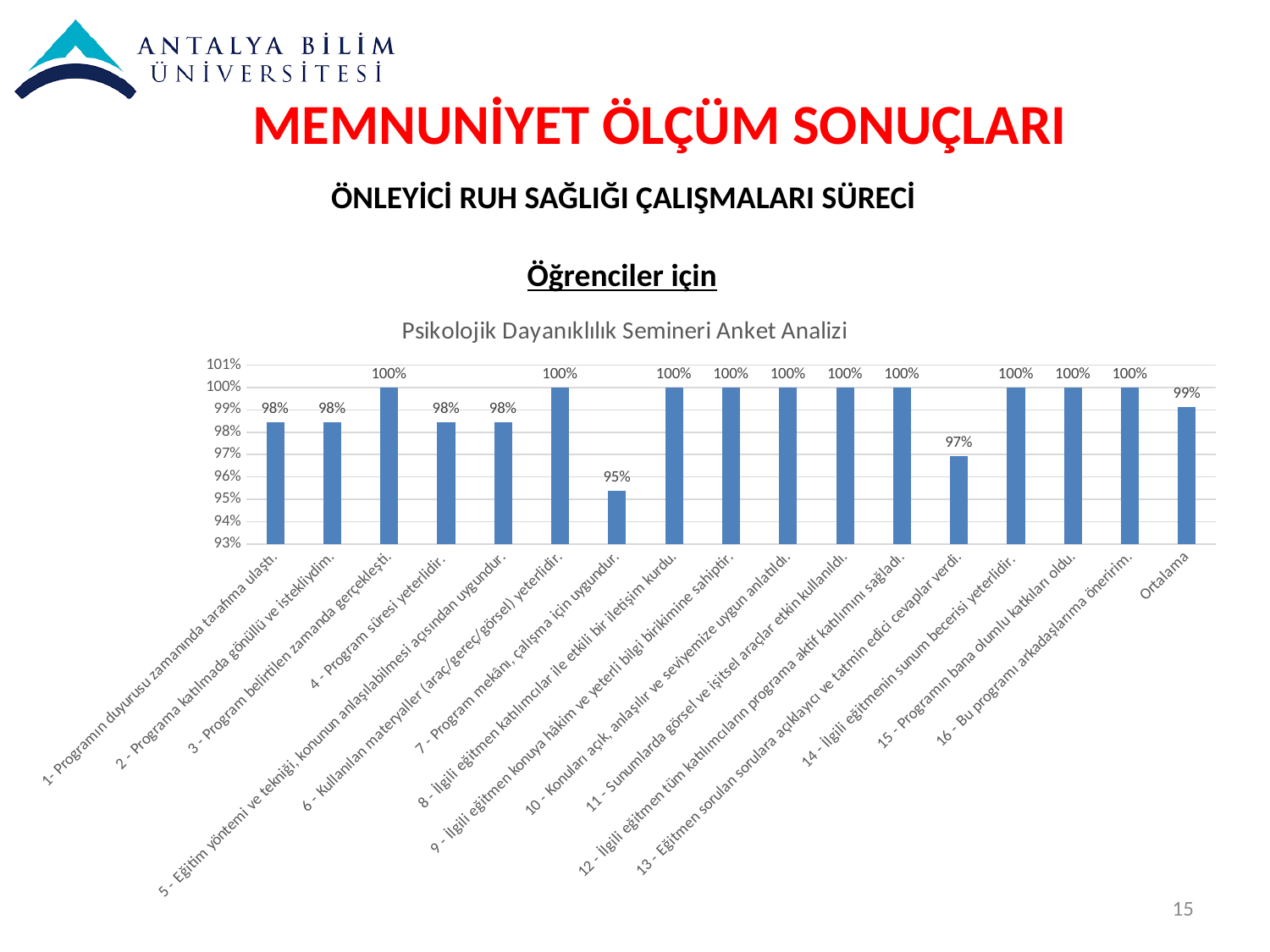
What is the value for "4 - Program süresi yeterlidir."? 98% How many bars are plotted in the chart? 17 Is the value for "7 - Program mekânı, çalışma için uygundur." greater or less than 96%? less What is the value for "Ortalama"? 99% Which category has the lowest value? 7 - Program mekânı, çalışma için uygundur. What is the value for "13 - Eğitmen sorulan sorulara açıklayıcı ve tatmin edici cevaplar verdi."? 97% What is the difference between the value for "3 - Program belirtilen zamanda gerçekleşti." and the value for "7 - Program mekânı, çalışma için uygundur."? 5% How many categories have a value of 100%? 10 What is the title of the chart? Psikolojik Dayanıklılık Semineri Anket Analizi Which is larger: the value for "13 - Eğitmen sorulan sorulara açıklayıcı ve tatmin edici cevaplar verdi." or the value for "1- Programın duyurusu zamanında tarafıma ulaştı."? 1- Programın duyurusu zamanında tarafıma ulaştı. What kind of chart is shown on the slide? bar chart What is the value for "7 - Program mekânı, çalışma için uygundur."? 95%